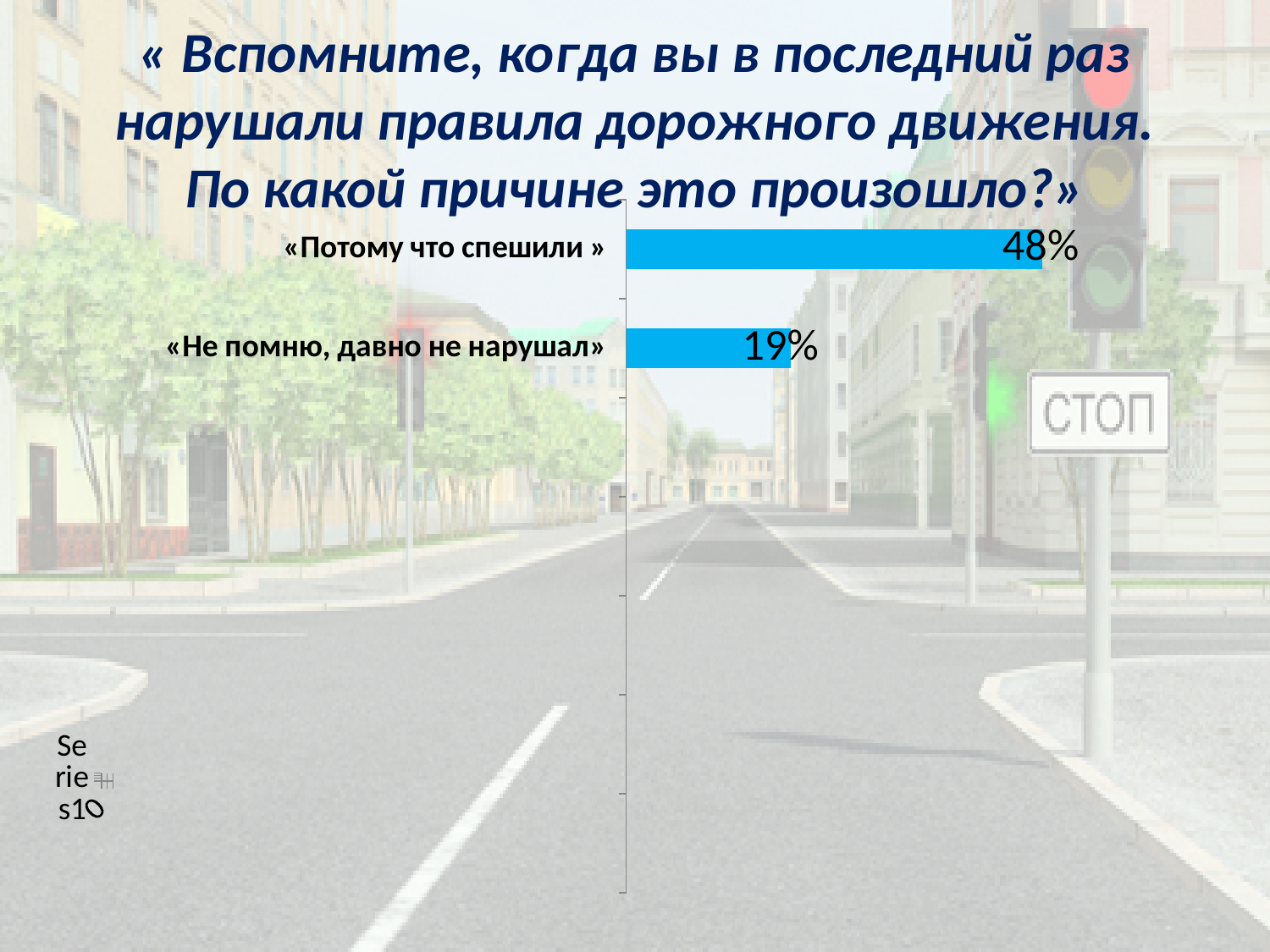
What colour are the bars in the chart? Blue Which is larger: the value for «Потому что спешили» or for «Не помню, давно не нарушал»? «Потому что спешили» Which category has the highest value? «Потому что спешили» What is the difference between the values for «Потому что спешили» and «Не помню, давно не нарушал»? 29% What is the value for «Потому что спешили»? 48% What is the value for «Не помню, давно не нарушал»? 19% Which category has the lowest value? «Не помню, давно не нарушал» What kind of chart is shown on the slide? Bar chart How many categories are shown in the chart? 2 Are the bars in the chart horizontal or vertical? Horizontal